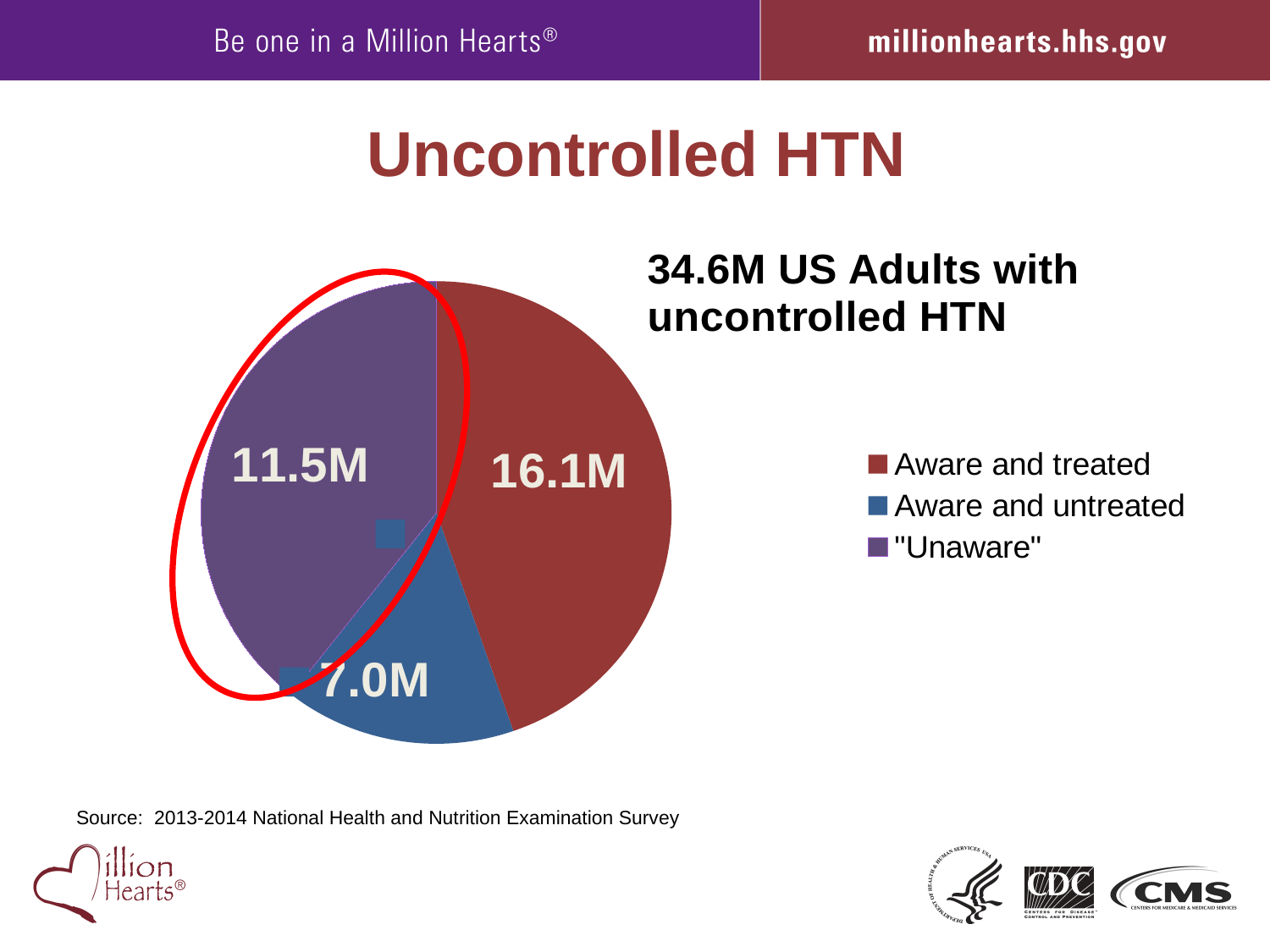
Which category has the smallest slice of the pie? Aware and untreated What is the value for the "Unaware" slice? 11.5M How many slices does the pie chart have? 3 Which slice of the pie is circled in red? Unaware What is the total number of US adults with uncontrolled HTN shown on the slide? 34.6M What is the difference between the "Aware and treated" and "Unaware" values? 4.6M How many entries does the legend list? 3 What is the value for the "Aware and untreated" slice? 7.0M What is the value for the "Aware and treated" slice? 16.1M Which category has the largest slice of the pie? Aware and treated Which is larger, the "Unaware" slice or the "Aware and untreated" slice? Unaware What type of chart is shown on the slide? pie chart